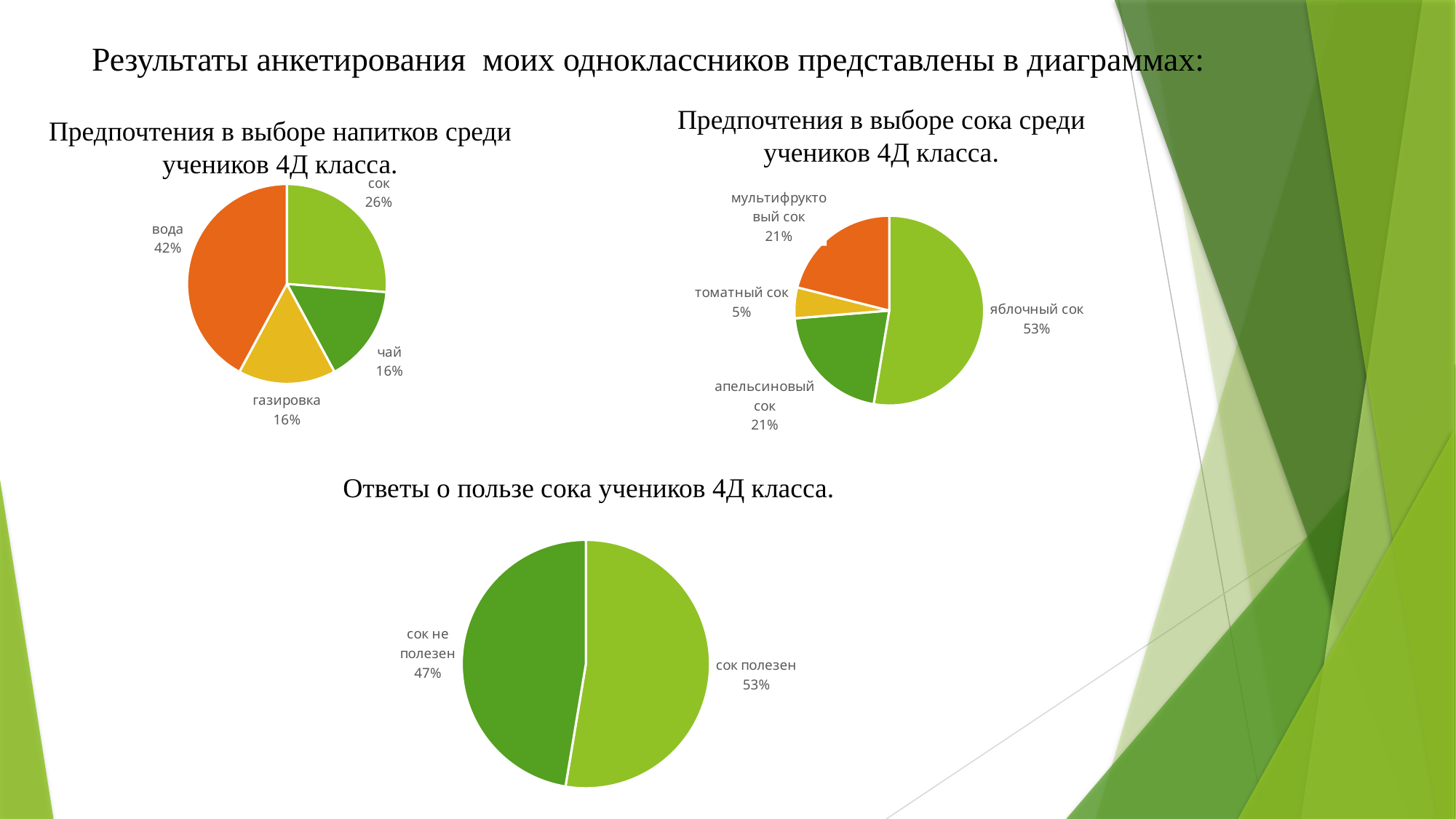
In the bottom chart (Ответы о пользе сока учеников 4Д класса), what is the difference between the shares for сок полезен and сок не полезен? 6% In the top-left chart (Предпочтения в выборе напитков среди учеников 4Д класса), how many categories are shown? 4 In the top-right chart (Предпочтения в выборе сока среди учеников 4Д класса), which juice has the smallest share? томатный сок How many charts are shown on the slide? 3 In the top-left chart (Предпочтения в выборе напитков среди учеников 4Д класса), what share of students chose вода? 42% In the top-right chart (Предпочтения в выборе сока среди учеников 4Д класса), which is larger: the share for яблочный сок or апельсиновый сок? яблочный сок In the top-right chart (Предпочтения в выборе сока среди учеников 4Д класса), how many categories are shown? 4 In the top-left chart (Предпочтения в выборе напитков среди учеников 4Д класса), what is the difference between the shares for вода and сок? 16% In the top-right chart (Предпочтения в выборе сока среди учеников 4Д класса), what share of students chose яблочный сок? 53% In the bottom chart (Ответы о пользе сока учеников 4Д класса), what share of students answered сок полезен? 53% What type of chart is the bottom chart (Ответы о пользе сока учеников 4Д класса)? pie chart In the top-left chart (Предпочтения в выборе напитков среди учеников 4Д класса), which drink has the largest share? вода